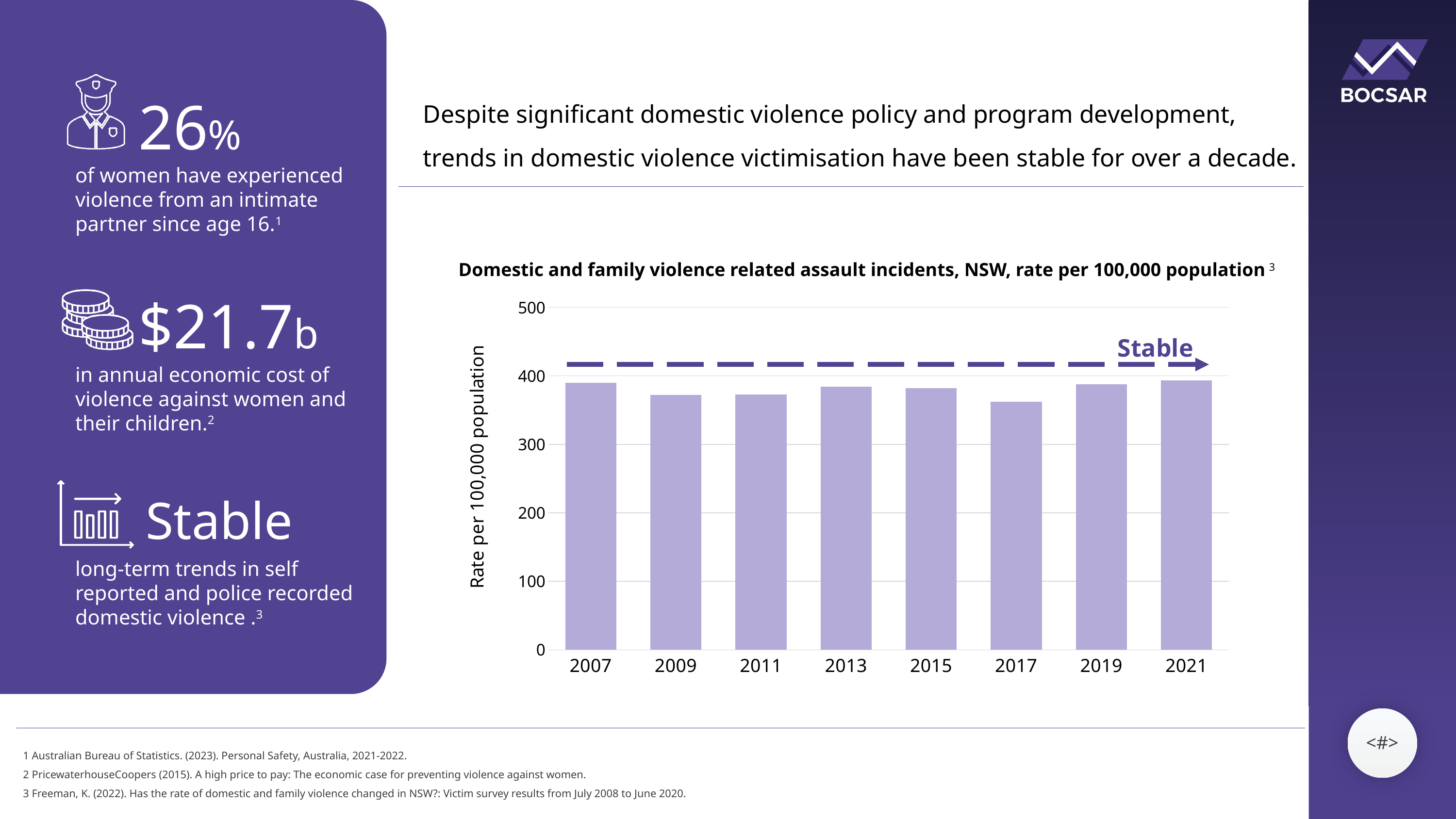
Which is larger, the value for 2013 or the value for 2017? 2013 Do the values in the chart show a strong rising trend, a strong falling trend, or remain roughly stable from 2007 to 2021? Roughly stable Is the value for 2007 greater or less than 400? less Is the value for 2017 greater or less than 400? less How many years are plotted on the x axis of the chart? 8 Is the value for 2021 greater or less than 300? greater What kind of chart is shown on the slide? Bar chart Which year has the lowest rate of domestic and family violence related assault incidents? 2017 Which is larger, the value for 2007 or the value for 2009? 2007 What is the title of the chart? Domestic and family violence related assault incidents, NSW, rate per 100,000 population What word labels the dashed arrow above the bars in the chart? Stable